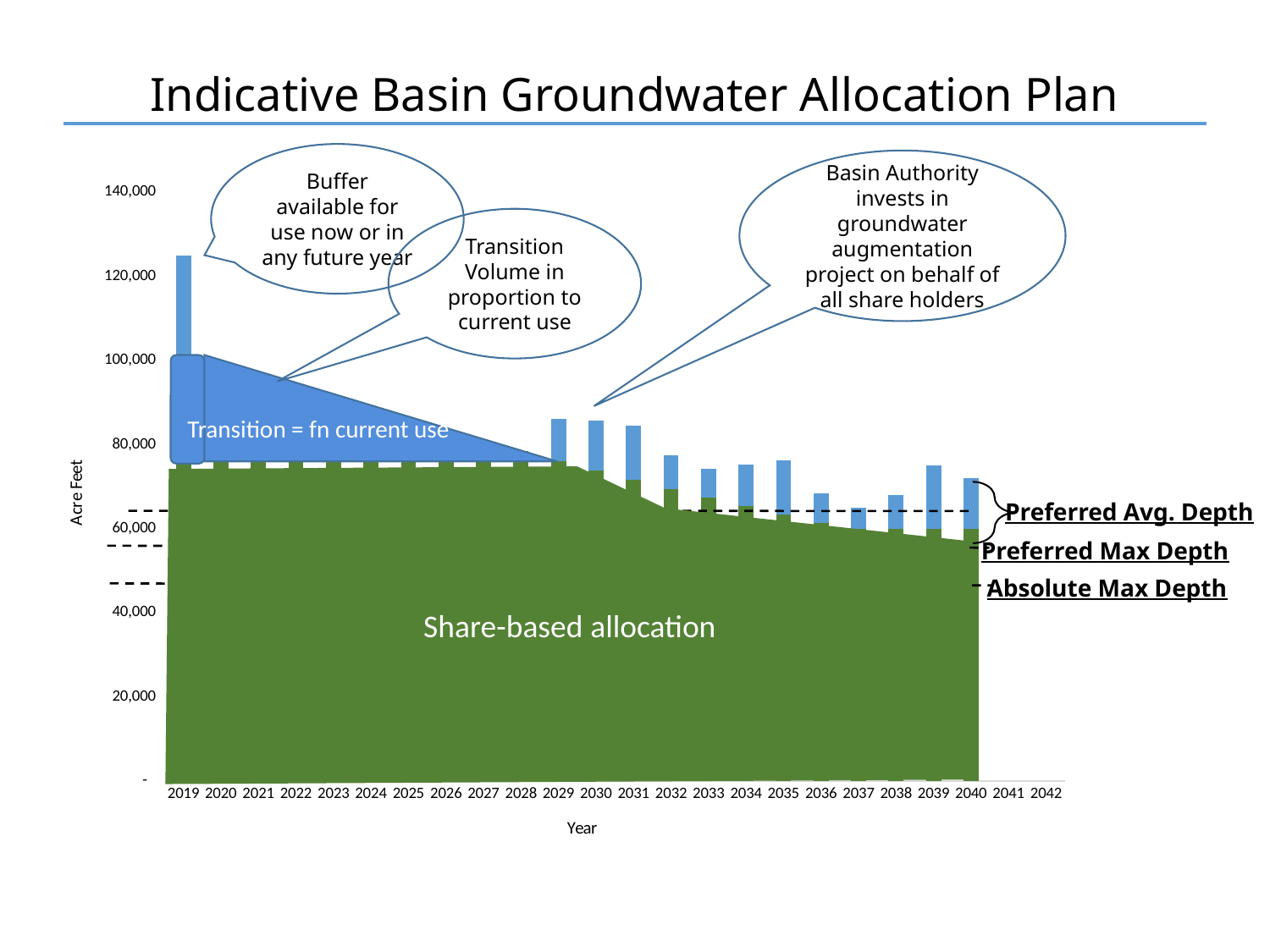
What is the title of the horizontal axis of the chart? Year Which year has the tallest bar in the chart? 2019 Is the total bar height for 2019 greater or less than 100,000 acre feet? greater Is the total bar height for 2033 greater or less than 80,000 acre feet? less What kind of chart is shown on the slide? bar chart Is the green share-based allocation for 2019 greater or less than 60,000 acre feet? greater How many years are labelled along the x axis of the chart? 24 Which year has the taller bar, 2019 or 2029? 2019 Does the green share-based allocation rise or fall from 2019 to 2040? fall What is the title of the vertical axis of the chart? Acre Feet